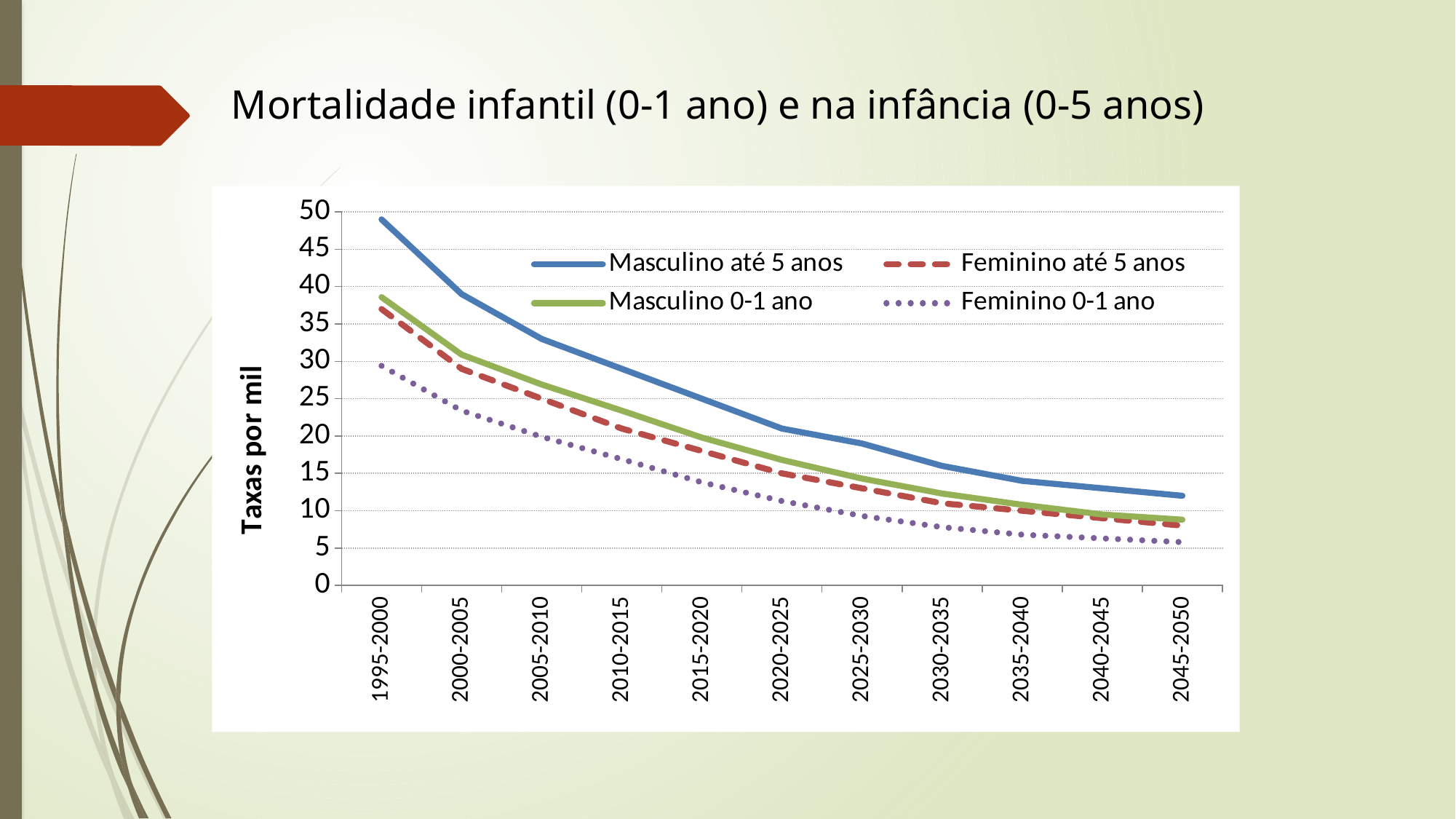
Which series has the highest value in 1995-2000? Masculino até 5 anos What kind of chart is shown on the slide? line chart In 1995-2000, which is larger: the value for Masculino até 5 anos or the value for Feminino 0-1 ano? Masculino até 5 anos What is the label of the y axis? Taxas por mil How many periods are shown on the x axis? 11 How many series does the legend list? 4 Is the value for Feminino 0-1 ano in 2045-2050 greater or less than 10? less Is the value for Masculino até 5 anos in 1995-2000 greater or less than 45? greater Is the value for Masculino 0-1 ano in 1995-2000 greater or less than 35? greater Which series has the lowest value in 2045-2050? Feminino 0-1 ano Do the values for Masculino até 5 anos rise or fall from 1995-2000 to 2045-2050? fall